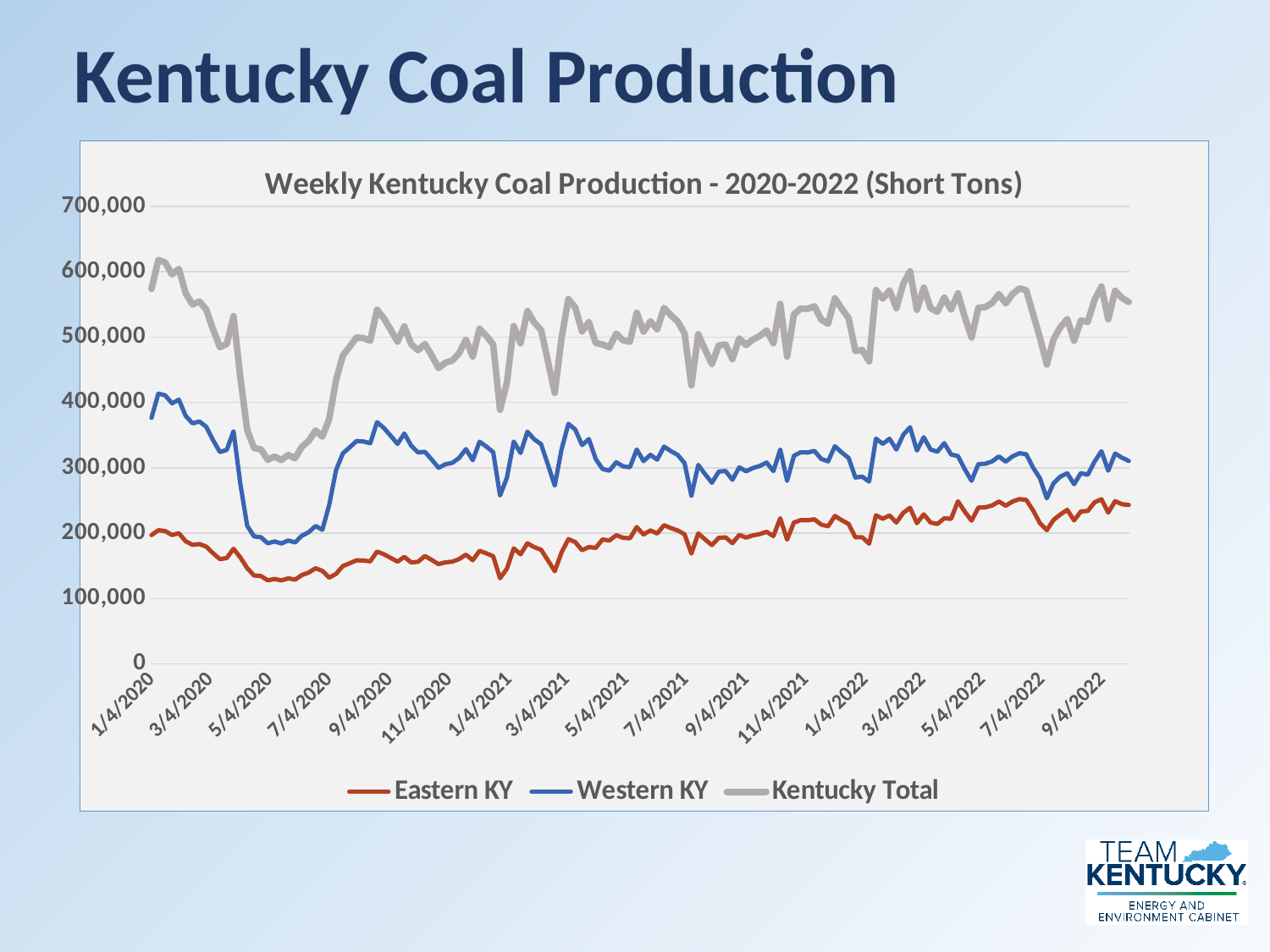
Which series has the lowest values throughout the chart? Eastern KY Which series has the highest values throughout the chart? Kentucky Total Is the value for Kentucky Total around 5/4/2020 greater or less than 400,000? less Is the value for Kentucky Total at 1/4/2020 greater or less than 500,000? greater What kind of chart is shown on the slide? Line chart Does the Kentucky Total series rise or fall between 1/4/2020 and 5/4/2020? Fall How many series does the legend list? 3 Is the value for Western KY at 1/4/2020 greater or less than 300,000? greater Which series is drawn in gray? Kentucky Total What is the title of the chart? Weekly Kentucky Coal Production - 2020-2022 (Short Tons) Which series is higher at 9/4/2022, Western KY or Eastern KY? Western KY